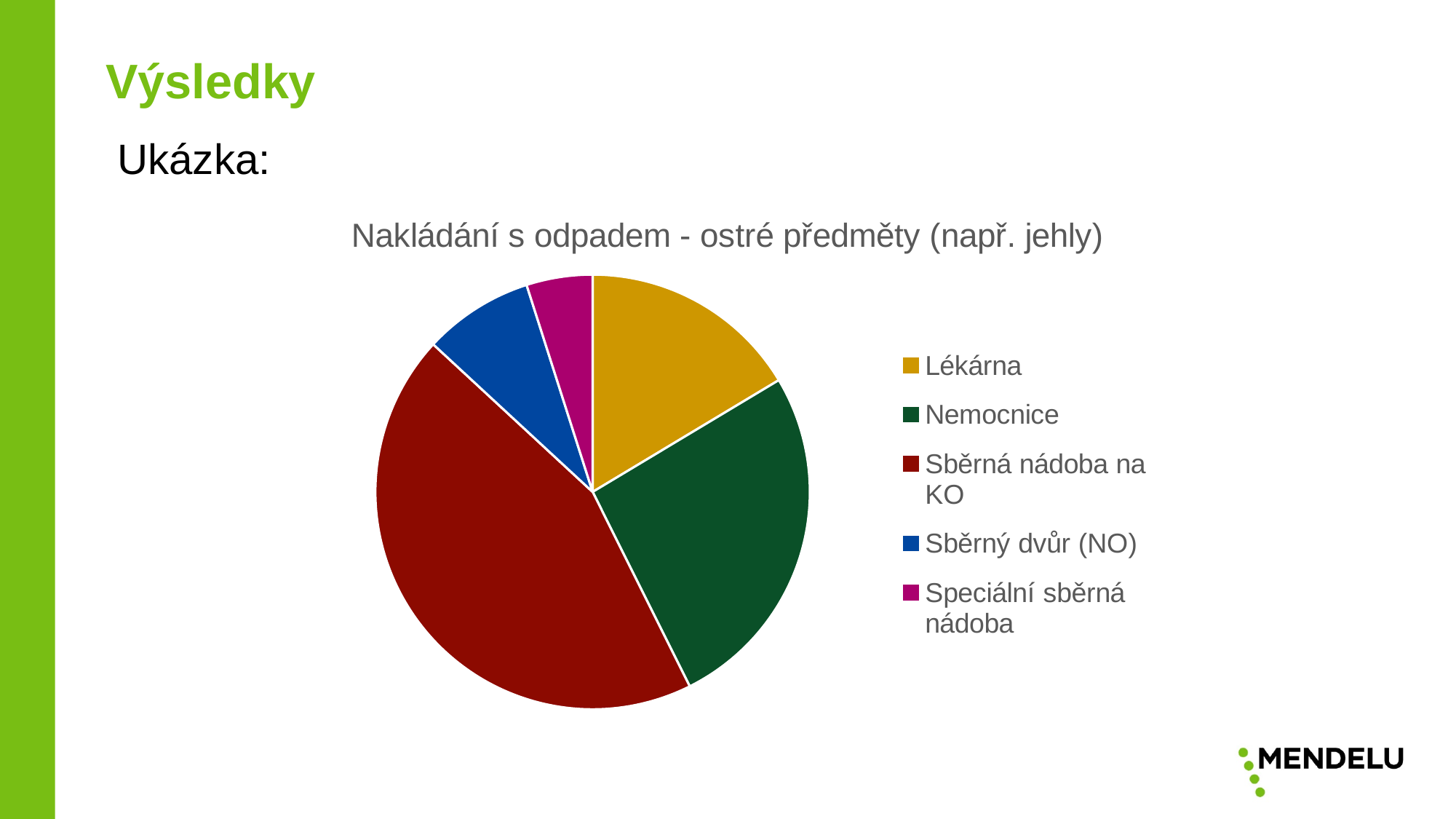
Which slice is larger, Sběrná nádoba na KO or Nemocnice? Sběrná nádoba na KO Which slice is larger, Nemocnice or Lékárna? Nemocnice Which category is shown in blue in the pie chart? Sběrný dvůr (NO) Which category has the smallest slice of the pie chart? Speciální sběrná nádoba How many categories does the legend of the pie chart list? 5 Which slice is larger, Lékárna or Sběrný dvůr (NO)? Lékárna What is the title of the chart? Nakládání s odpadem - ostré předměty (např. jehly) Which category has the largest slice of the pie chart? Sběrná nádoba na KO What kind of chart is shown on the slide? Pie chart How many slices does the pie chart have? 5